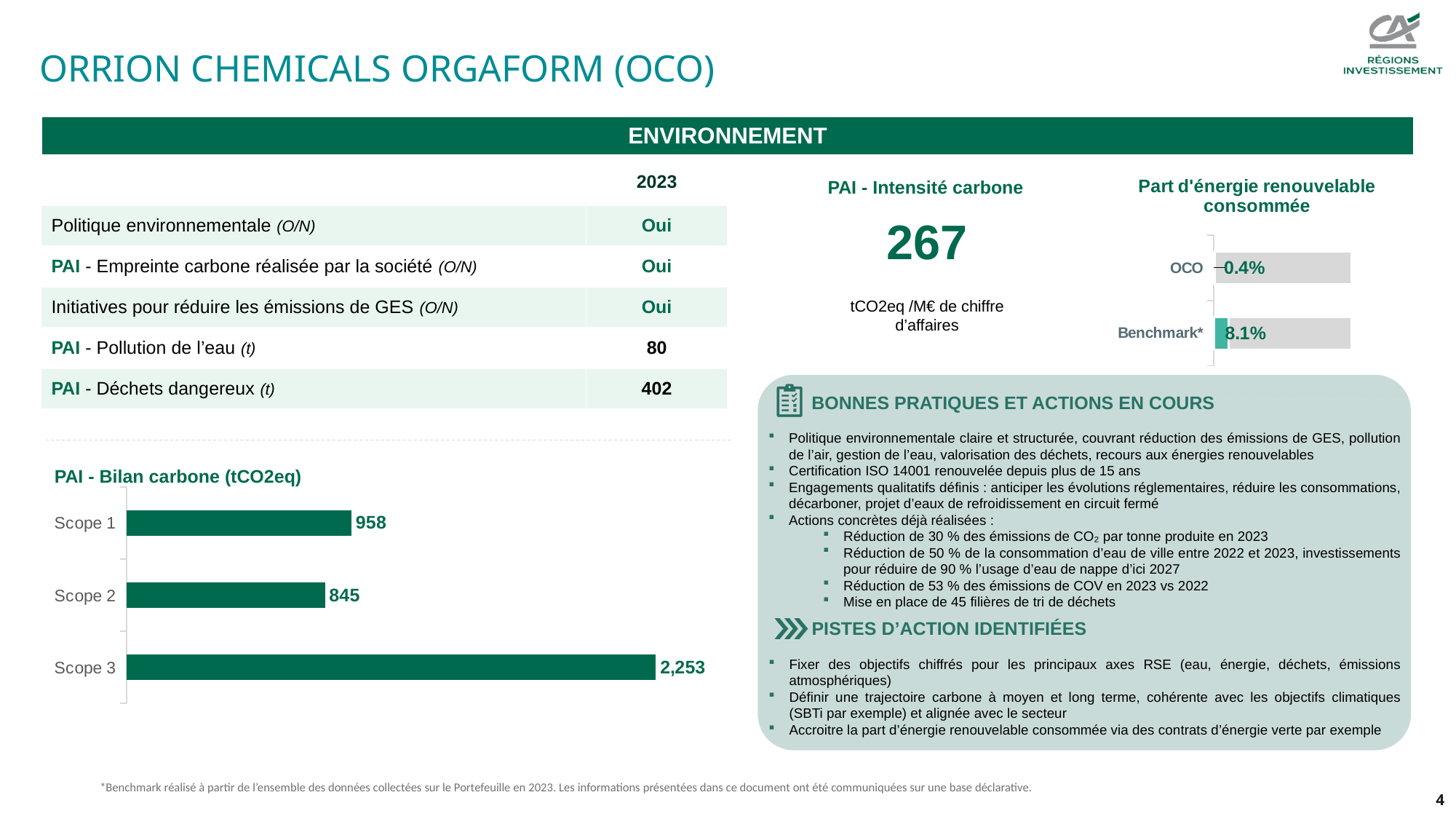
In the 'PAI - Bilan carbone (tCO2eq)' chart, what is the difference between Scope 1 and Scope 2? 113 What kind of chart is 'PAI - Bilan carbone (tCO2eq)'? Bar chart In the 'Part d'énergie renouvelable consommée' chart, what is the value for Benchmark*? 8.1% In the 'PAI - Bilan carbone (tCO2eq)' chart, how many scopes are plotted? 3 In the 'Part d'énergie renouvelable consommée' chart, how many categories are shown? 2 In the 'Part d'énergie renouvelable consommée' chart, which is larger, OCO or Benchmark*? Benchmark* In the 'Part d'énergie renouvelable consommée' chart, what is the difference between Benchmark* and OCO? 7.7% In the 'PAI - Bilan carbone (tCO2eq)' chart, what is the value for Scope 3? 2,253 In the 'PAI - Bilan carbone (tCO2eq)' chart, which scope has the lowest value? Scope 2 In the 'Part d'énergie renouvelable consommée' chart, what is the value for OCO? 0.4% In the 'PAI - Bilan carbone (tCO2eq)' chart, which scope has the highest value? Scope 3 In the 'PAI - Bilan carbone (tCO2eq)' chart, what is the value for Scope 1? 958